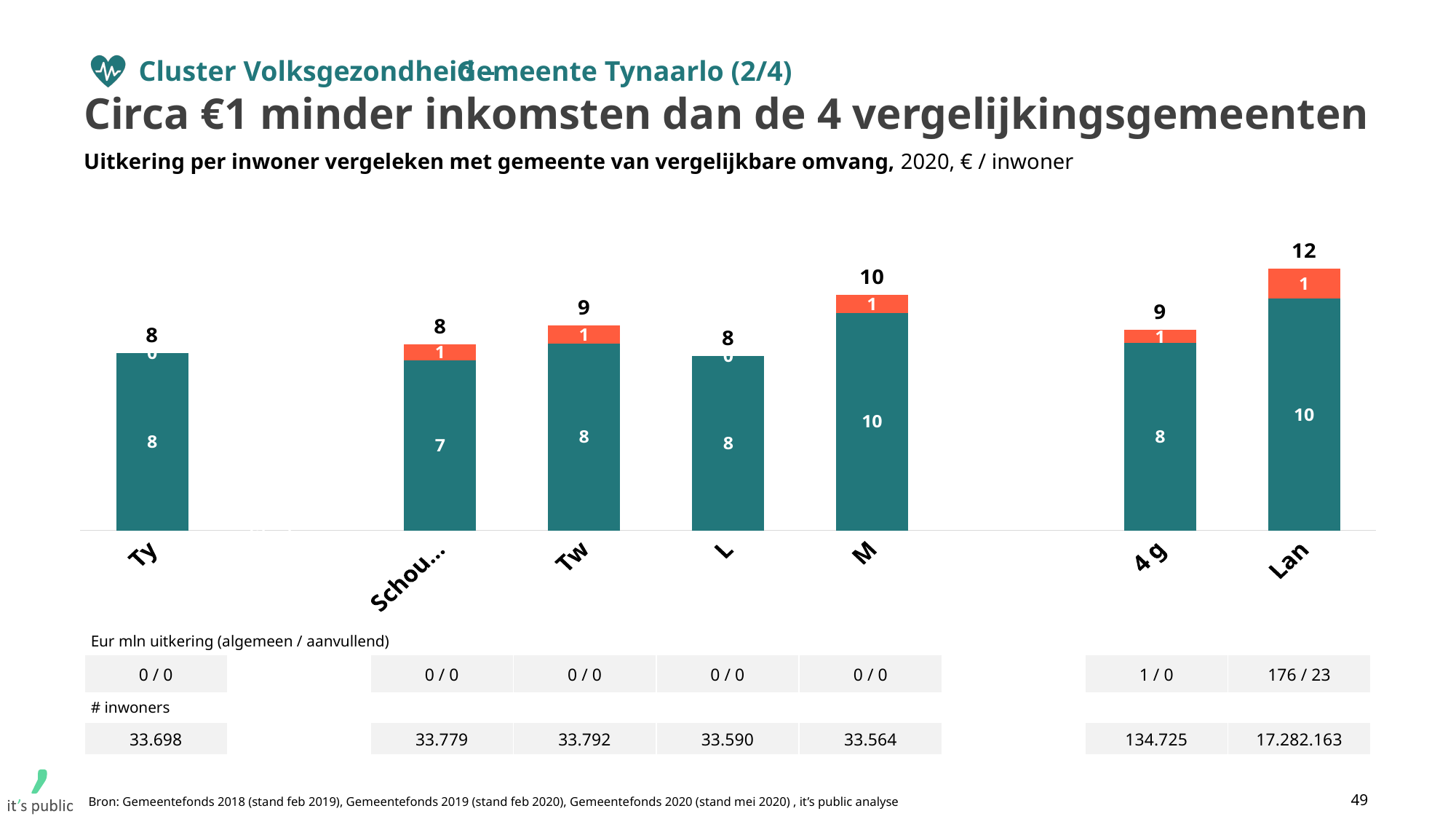
What type of chart is shown on the slide? stacked bar chart What is the total value shown above the bar labelled 'Ty'? 8 How many bars (categories) are plotted in the chart? 7 What is the number of inhabitants (# inwoners) shown below the bar labelled 'Ty'? 33.698 Which bar has the highest total value? Lan What is the total value shown above the bar labelled '4 g'? 9 What is the value of the teal (lower) segment of the bar labelled 'Schou...'? 7 What is the total value shown above the bar labelled 'Lan'? 12 Which has a larger total value, the bar labelled 'M' or the bar labelled 'L'? M What is the difference between the total for 'Lan' and the total for 'Ty'? 4 What is the value of the orange (upper) segment of the bar labelled 'Tw'? 1 What is the total value shown above the bar labelled 'M'? 10